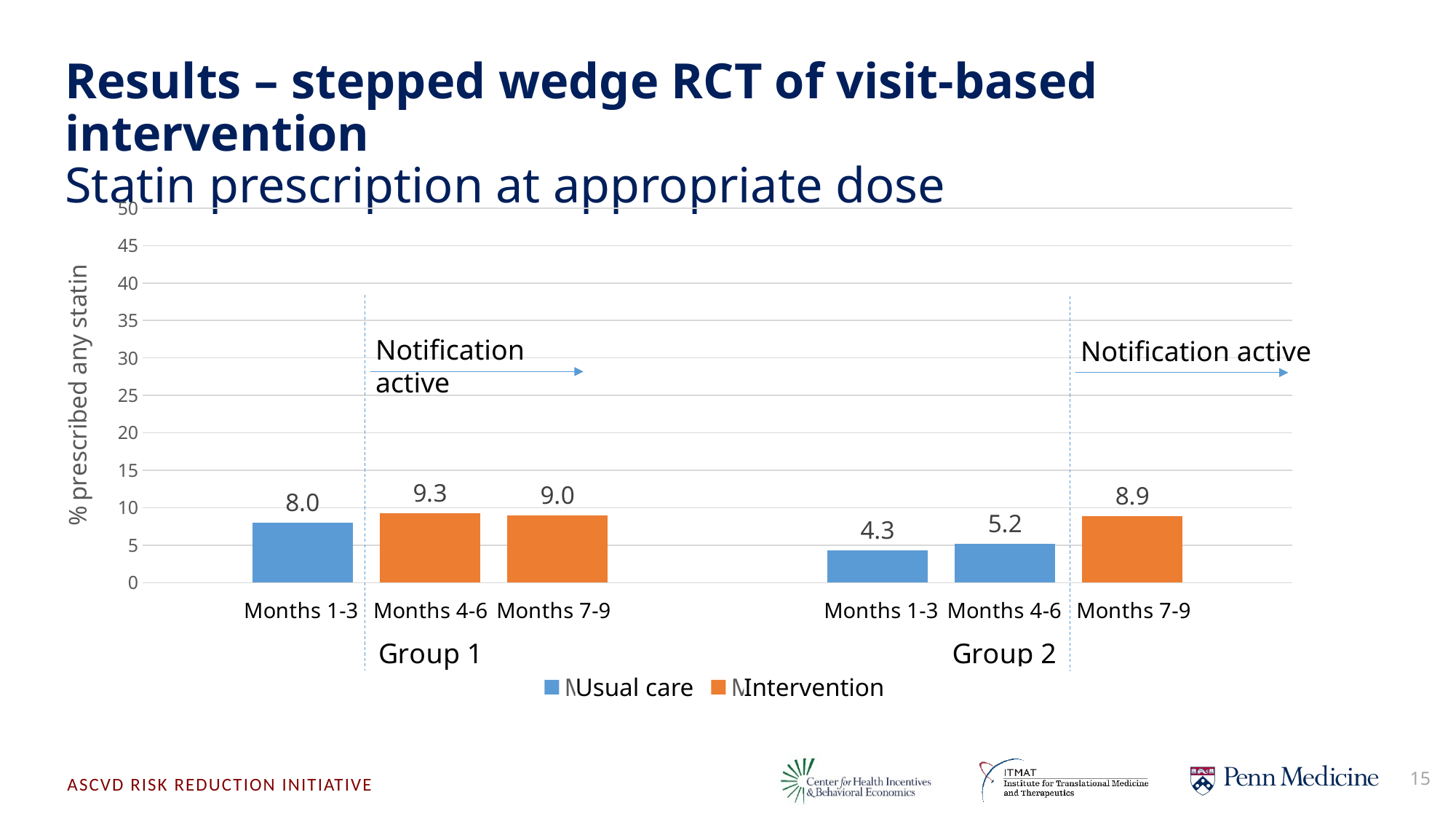
What kind of chart is shown? bar chart What is the y-axis label of the chart? % prescribed any statin Which bar has the lowest value? Group 2, Months 1-3 What is the value for Group 2, Months 7-9? 8.9 How many series does the legend list? 2 What is the value for Group 1, Months 1-3? 8.0 What is the difference between Group 2 Months 7-9 and Group 2 Months 4-6? 3.7 Which bar has the highest value? Group 1, Months 4-6 Is the value for Group 1 Months 4-6 greater or less than 10? less What is the value for Group 2, Months 1-3? 4.3 How many bars are plotted in the chart? 6 Which is larger: Group 1 Months 1-3 or Group 2 Months 1-3? Group 1 Months 1-3